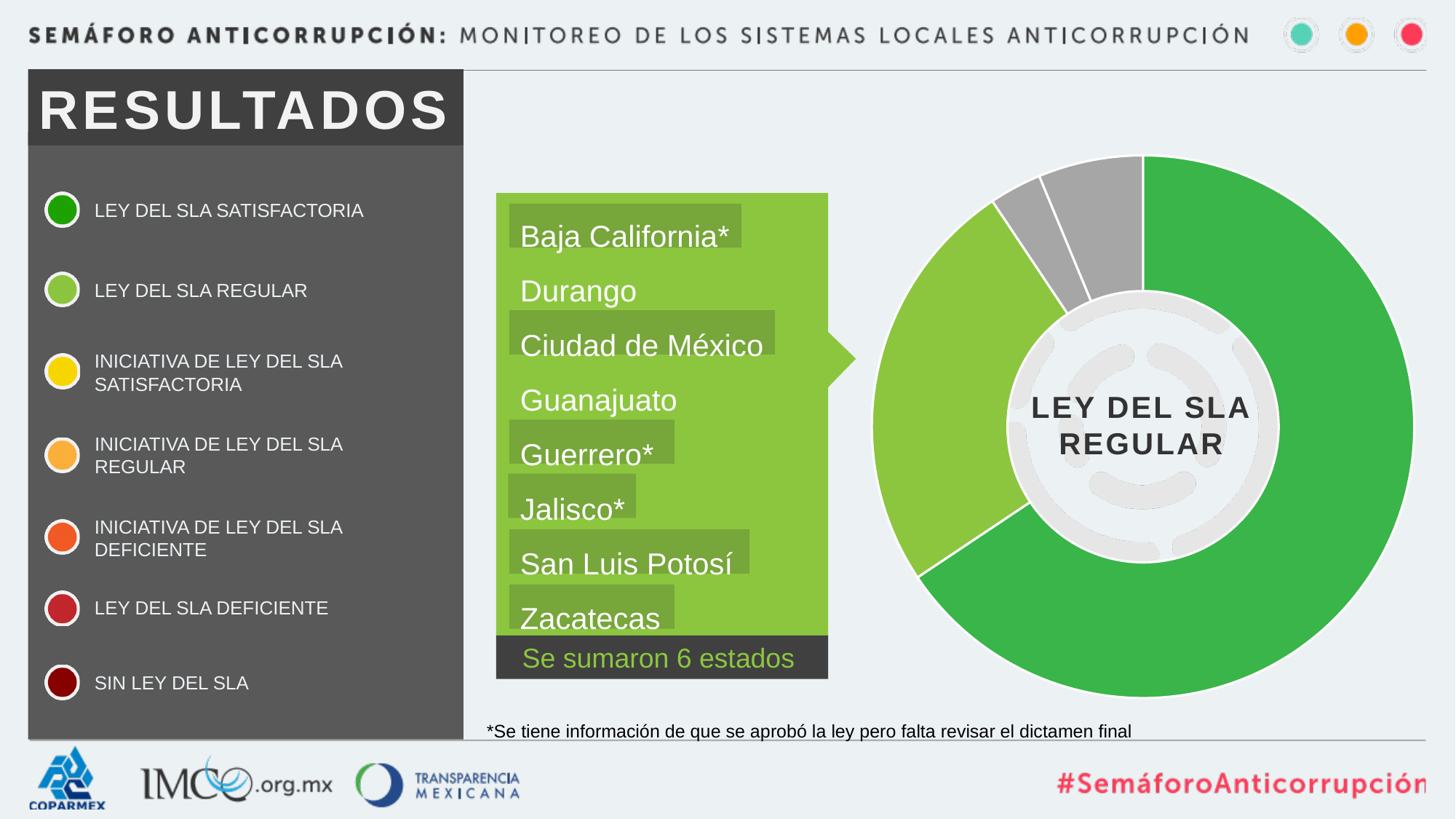
How many states does the callout say were added ('Se sumaron ... estados')? 6 What text is written in the centre of the donut chart? LEY DEL SLA REGULAR Which is larger in the donut chart, the dark green slice or the light green slice? Dark green How many of the states listed in the callout are marked with an asterisk? 3 Which colour slice is the largest in the donut chart? Dark green According to the legend on the left, which category does the dark green colour represent? LEY DEL SLA SATISFACTORIA Which state is listed last in the callout box for the light green slice? Zacatecas How many slices does the donut chart have? 4 What kind of chart is shown on the right side of the slide? Donut (pie) chart How many categories does the legend on the left of the slide list? 7 How many states are listed in the callout box pointing to the light green slice? 8 Which state is listed first in the callout box for the light green slice? Baja California*